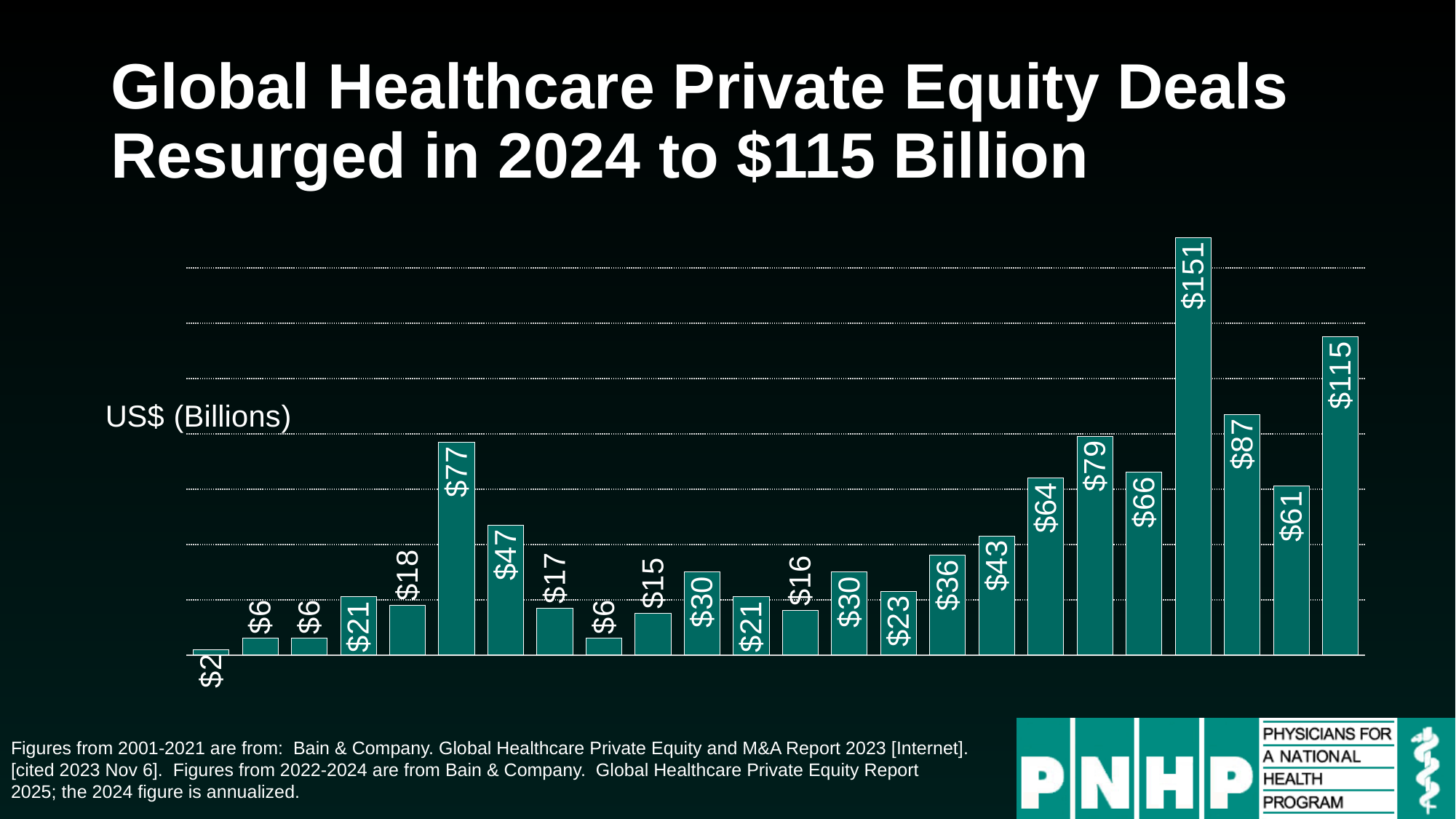
What is the lowest value shown on the chart? $2 What is the value of the bar immediately to the left of the tallest bar? $66 What is the value of the first (leftmost) bar on the chart? $2 What is the difference between the rightmost bar ($115) and the bar just before it ($61)? $54 What is the value of the last (rightmost) bar on the chart? $115 What kind of chart is shown on the slide? bar chart What unit label is shown next to the vertical axis of the chart? US$ (Billions) What is the highest value shown on the chart? $151 Which is larger, the rightmost bar or the bar immediately to its left? the rightmost bar What is the difference between the tallest bar ($151) and the rightmost bar ($115)? $36 How many bars are plotted on the chart? 24 Do the values generally rise or fall from left to right across the chart? rise